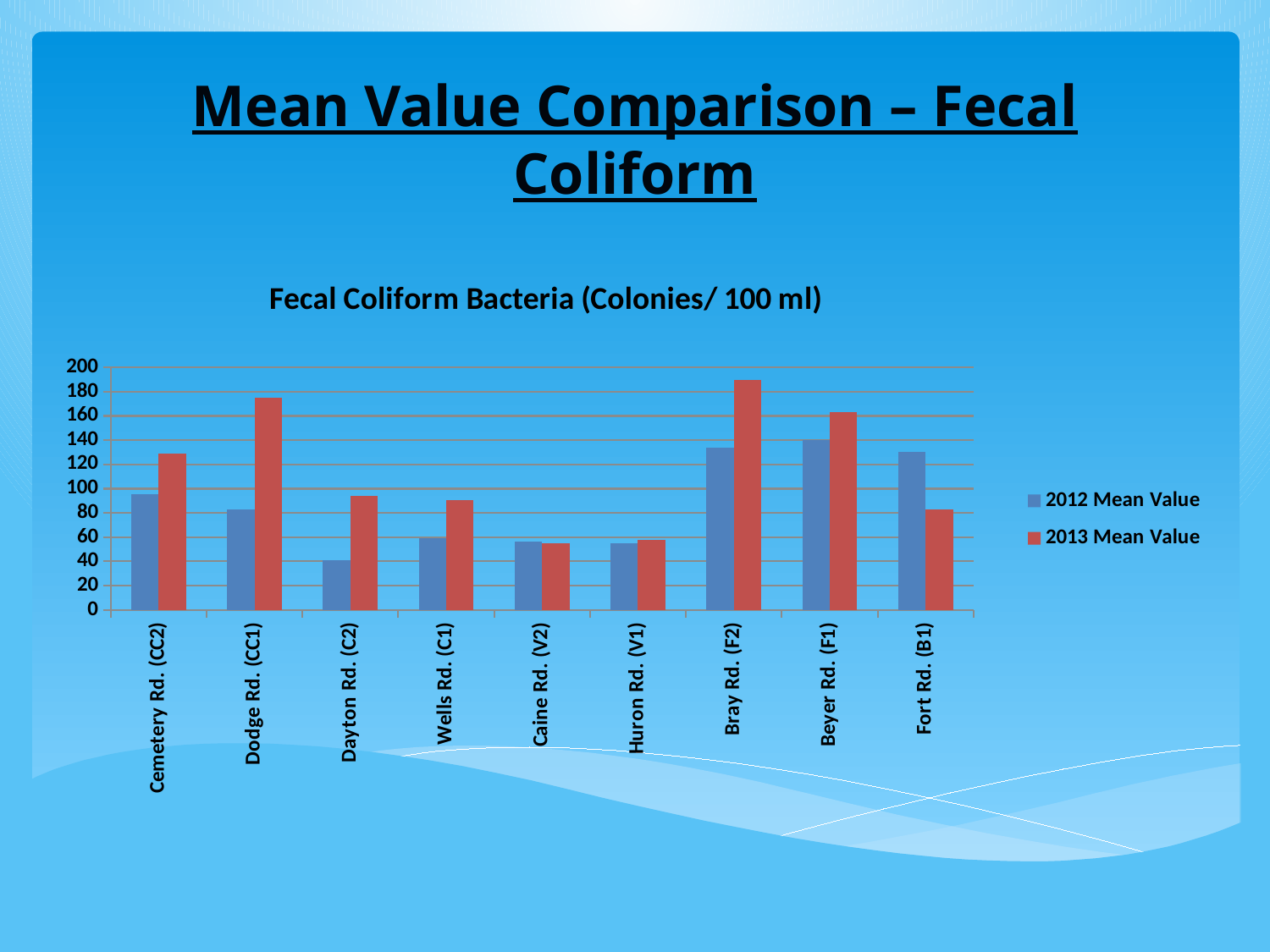
Is the 2013 Mean Value for Dodge Rd. (CC1) greater or less than 160? greater Is the 2012 Mean Value for Dayton Rd. (C2) greater or less than 60? less At Dodge Rd. (CC1), which is larger: the 2012 Mean Value or the 2013 Mean Value? 2013 Mean Value At Fort Rd. (B1), which is larger: the 2012 Mean Value or the 2013 Mean Value? 2012 Mean Value What is the title of the chart? Fecal Coliform Bacteria (Colonies/ 100 ml) How many road sites are shown on the x axis? 9 Is the 2013 Mean Value for Fort Rd. (B1) greater or less than 100? less Which site has the highest 2013 Mean Value? Bray Rd. (F2) Which site has the lowest 2012 Mean Value? Dayton Rd. (C2) What kind of chart is shown on the slide? bar chart How many series does the legend list? 2